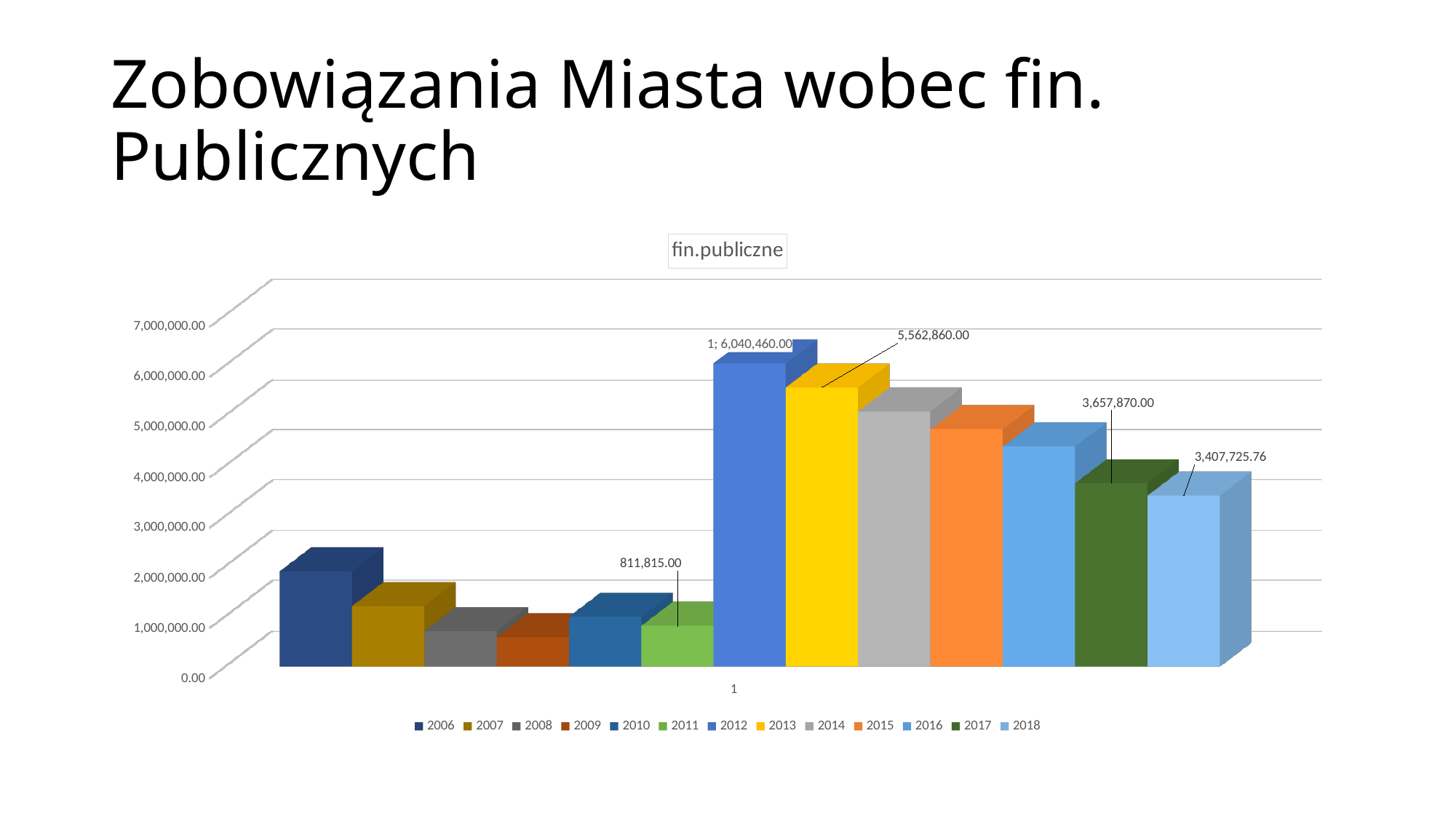
What is the difference between the values for 2017 and 2018? 250,144.24 Which is larger, the value for 2017 or the value for 2018? 2017 Which year has the highest value in the fin.publiczne chart? 2012 What is the value for 2011 in the fin.publiczne chart? 811,815.00 Is the value for 2014 greater or less than 4,000,000.00? greater What is the value for 2012 in the fin.publiczne chart? 6,040,460.00 How many series does the legend list? 13 What kind of chart is shown on the slide? bar chart What is the difference between the values for 2012 and 2013? 477,600.00 What is the value for 2013 in the fin.publiczne chart? 5,562,860.00 Is the value for 2006 greater or less than 3,000,000.00? less What is the value for 2018 in the fin.publiczne chart? 3,407,725.76